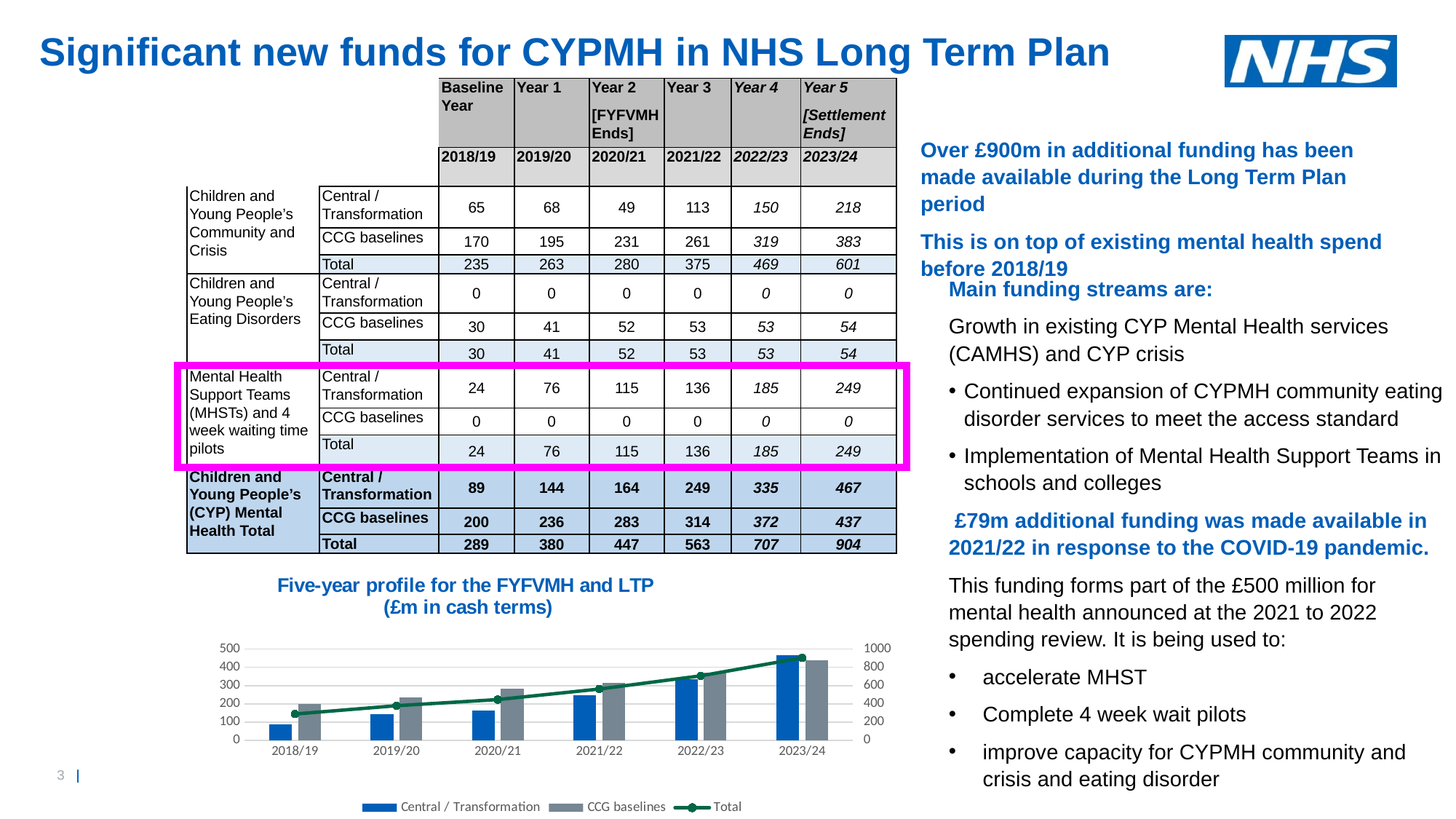
In 2018/19, which bar is taller: Central / Transformation or CCG baselines? CCG baselines Which colour are the Central / Transformation bars in the chart? blue On the right-hand axis, is the Total value for 2023/24 greater or less than 800? greater What kind of chart is shown under the title 'Five-year profile for the FYFVMH and LTP'? bar chart with a line Does the Total line rise or fall from 2018/19 to 2023/24? rises Is the Central / Transformation value for 2023/24 greater or less than 400? greater Is the Central / Transformation value for 2018/19 greater or less than 100? less How many years are shown on the x axis of the chart? 6 In which year is the Central / Transformation bar lowest? 2018/19 In which year is the Central / Transformation bar highest? 2023/24 How many series does the chart's legend list? 3 Which series in the chart is plotted as a line rather than bars? Total